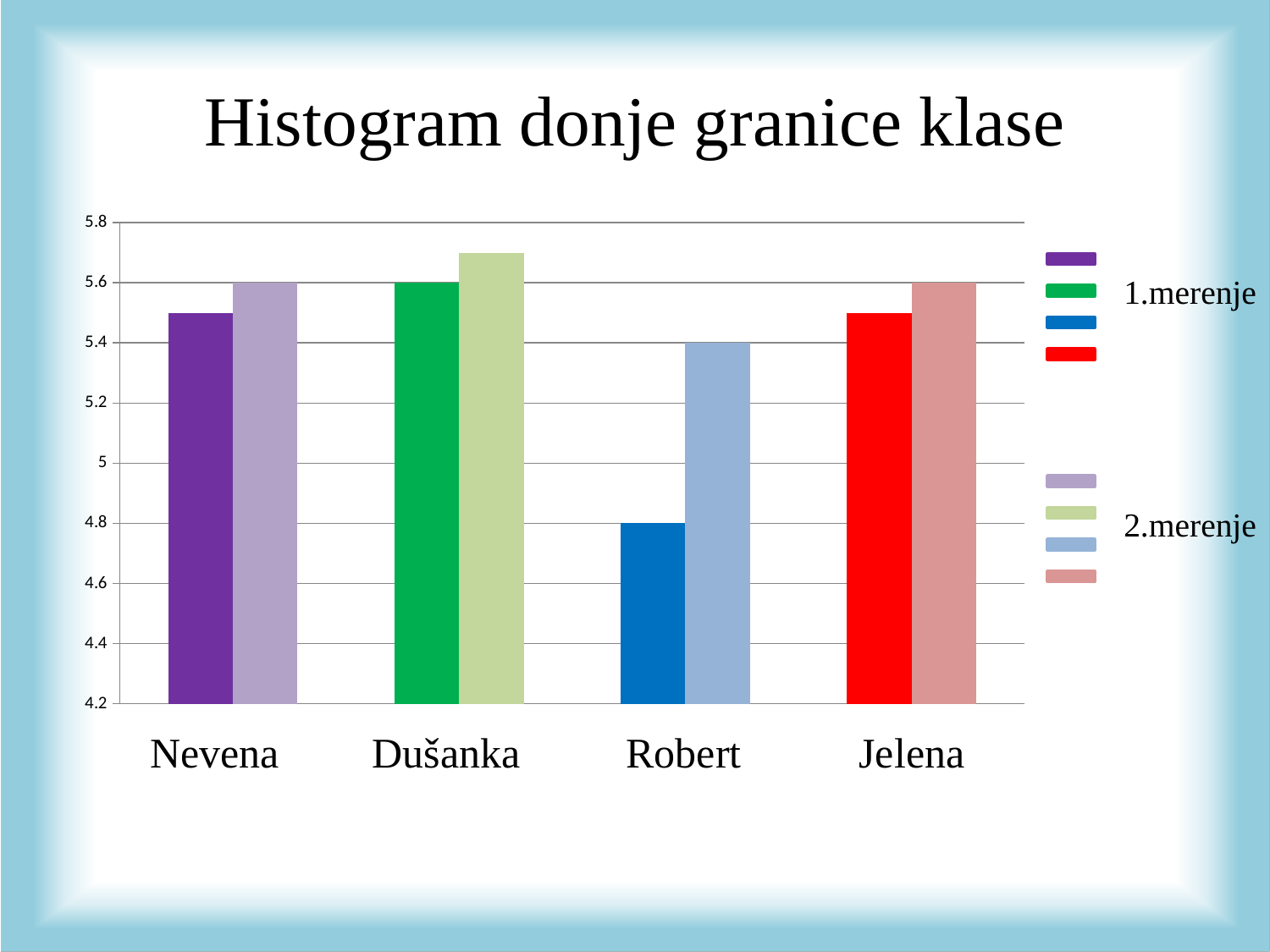
What is the title of the chart? Histogram donje granice klase Which person has the highest 2.merenje value? Dušanka How many categories (people) are shown on the x axis? 4 How many series does the legend list? 2 What is the 2.merenje value for Robert? 5.4 Is the 2.merenje value for Dušanka greater or less than 5.6? greater What is the difference between Robert's 2.merenje and 1.merenje values? 0.6 What is the 1.merenje value for Robert? 4.8 What type of chart is shown on the slide? bar chart Which person has the lowest 1.merenje value? Robert What is the 2.merenje value for Nevena? 5.6 What is the 1.merenje value for Dušanka? 5.6